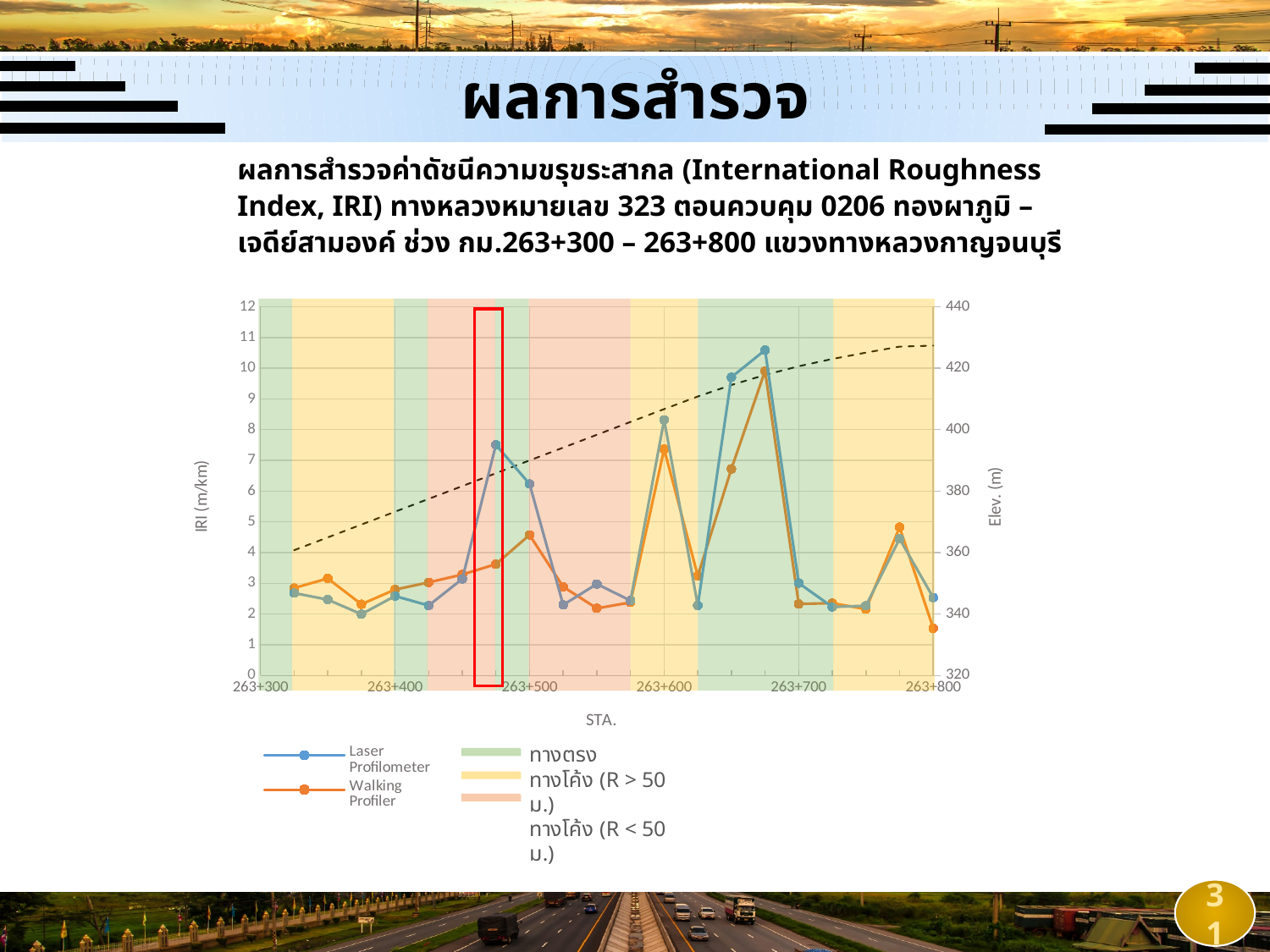
How many line series does the legend list for the IRI measurements? 2 Is the Laser Profilometer value at 263+600 greater or less than 8? greater Does the dashed elevation line rise or fall from 263+300 to 263+800? rise At 263+800, which series has the higher IRI value, Laser Profilometer or Walking Profiler? Laser Profilometer Is the Walking Profiler value at 263+800 greater or less than 2? less Which series reaches the higher peak IRI value, Laser Profilometer or Walking Profiler? Laser Profilometer What is the title of the left vertical axis? IRI (m/km) What is the title of the right vertical axis? Elev. (m) Is the highest Laser Profilometer value greater or less than 10? greater What kind of chart is shown on the slide? line chart How many station labels are shown on the x axis? 6